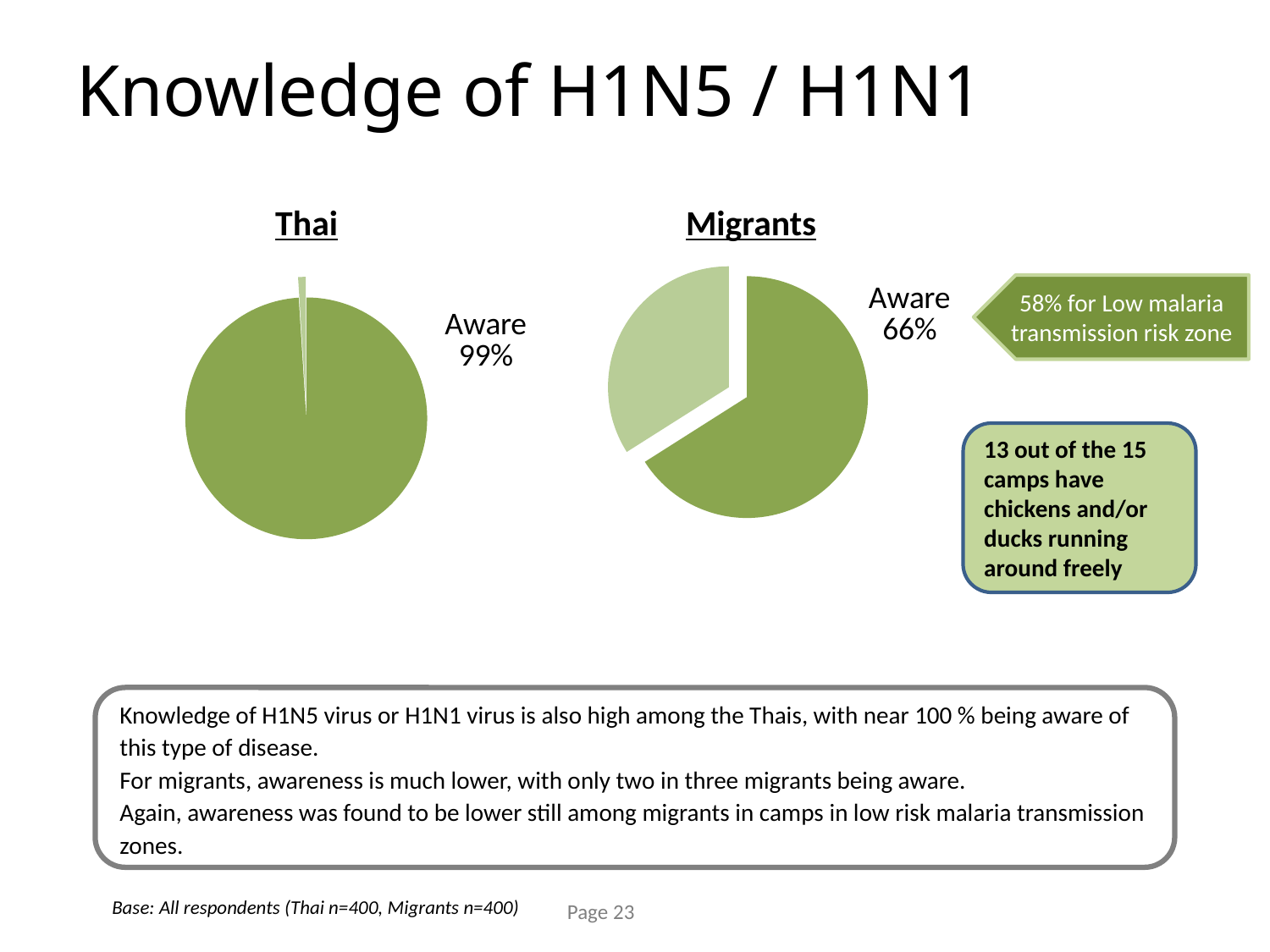
By how many percentage points does the Thai awareness share exceed the Migrants awareness share? 33 percentage points In the Migrants pie chart, what share of the pie does the 'Aware' slice represent? 66% Which group has the higher share of respondents aware of H1N5 / H1N1, Thai or Migrants? Thai How many slices does the Migrants pie chart have? 2 In the Migrants pie chart, what percentage of respondents are aware of H1N5 / H1N1? 66% Is the Migrants 'Aware' share greater or less than 50%? greater How many pie charts are shown on the slide? 2 In the Thai pie chart, what share of the pie does the 'Aware' slice represent? 99% What type of chart is used to show awareness for the Thai group? Pie chart What is the title of the slide containing the two pie charts? Knowledge of H1N5 / H1N1 What type of chart is used to show awareness for the Migrants group? Pie chart In the Thai pie chart, what percentage of respondents are aware of H1N5 / H1N1? 99%